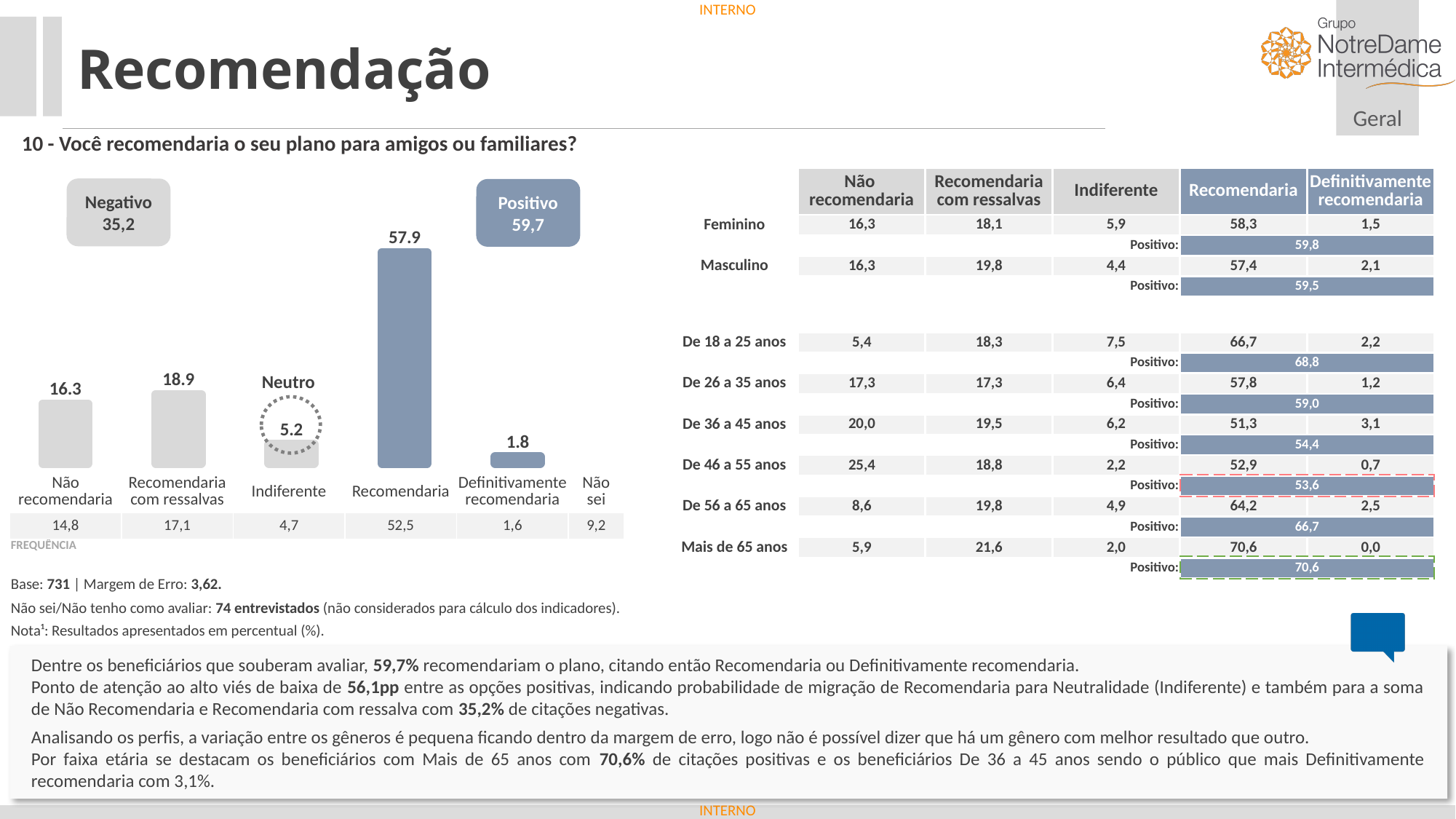
What is the value shown for Recomendaria in the bar chart? 57.9 What is the difference between the values for Recomendaria and Recomendaria com ressalvas in the bar chart? 39.0 What is the value shown for Definitivamente recomendaria in the bar chart? 1.8 What type of chart is shown on the left of the slide? Bar chart What is the value shown for Recomendaria com ressalvas in the bar chart? 18.9 What value is shown in the Positivo box next to the bar chart? 59,7 Which is larger in the bar chart, Não recomendaria or Recomendaria com ressalvas? Recomendaria com ressalvas What is the value shown for Não recomendaria in the bar chart? 16.3 What is the value shown for Indiferente in the bar chart? 5.2 What value is shown in the Negativo box next to the bar chart? 35,2 Which category has the highest value in the bar chart? Recomendaria Which category has the lowest value in the bar chart? Definitivamente recomendaria